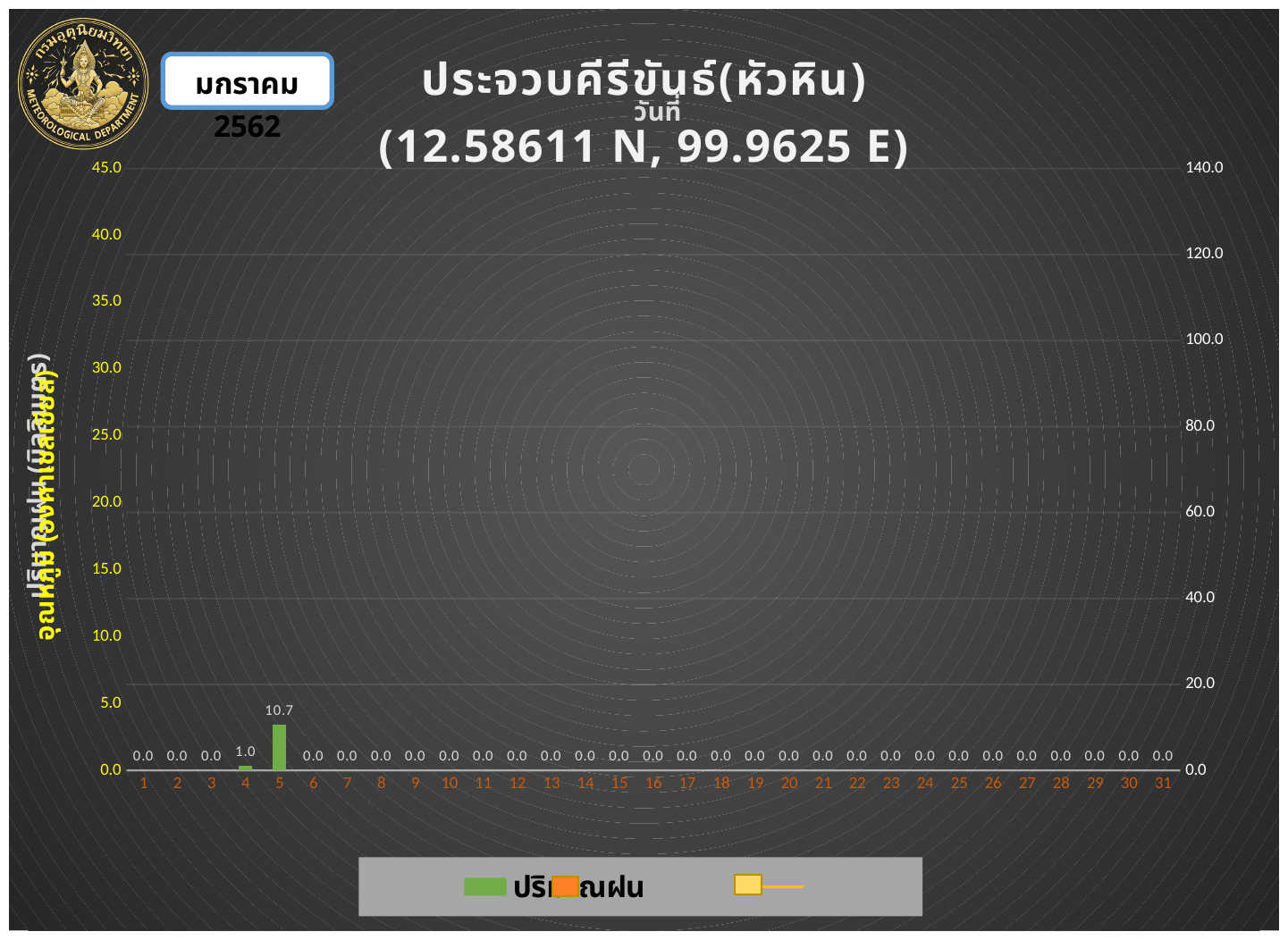
What is the value shown for day 31? 0.0 What is the value shown for day 5? 10.7 Which is larger, the value for day 4 or the value for day 5? day 5 What kind of chart is shown on the slide? bar chart What is the value shown for day 1? 0.0 How many days are shown on the x axis? 31 What month and year are shown in the label at the top left of the chart? มกราคม 2562 Is the value for day 5 greater or less than 5.0 on the left axis? greater What is the difference between the values for day 5 and day 4? 9.7 What is the value shown for day 4? 1.0 Which day has the highest value? 5 What is the sum of the values for all 31 days? 11.7